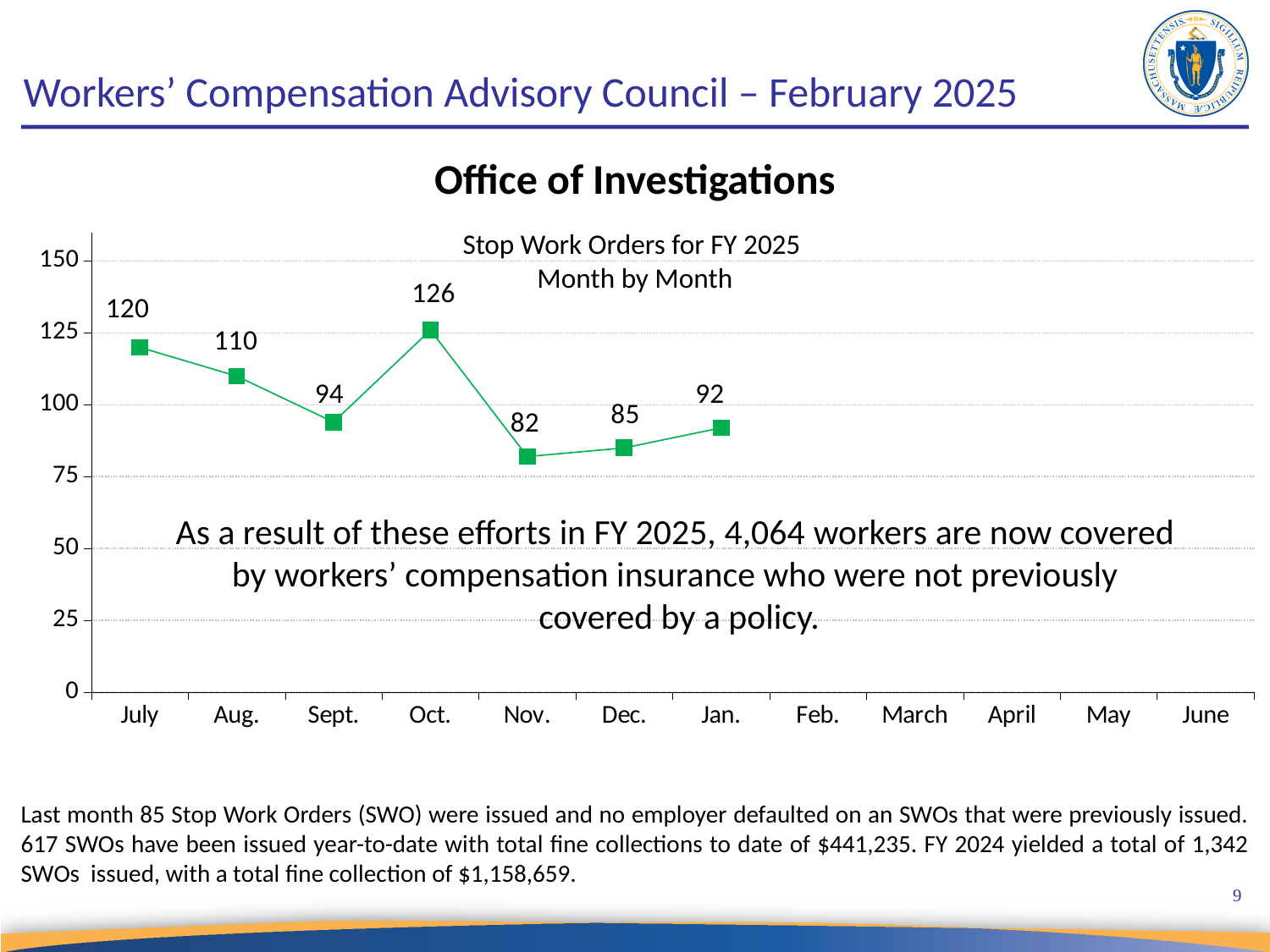
What kind of chart is shown on the slide? line chart Which month has more Stop Work Orders, September or January? Sept. What is the difference between the Stop Work Orders in October and in November? 44 How many months have a plotted data point on the chart? 7 Which month has the highest number of Stop Work Orders? Oct. Which month has the lowest number of Stop Work Orders? Nov. What is the difference between the Stop Work Orders in July and in August? 10 What is the number of Stop Work Orders for October? 126 Is the value for December greater or less than 100? less What is the number of Stop Work Orders for July? 120 What is the title of the chart? Stop Work Orders for FY 2025 Month by Month What is the number of Stop Work Orders for November? 82